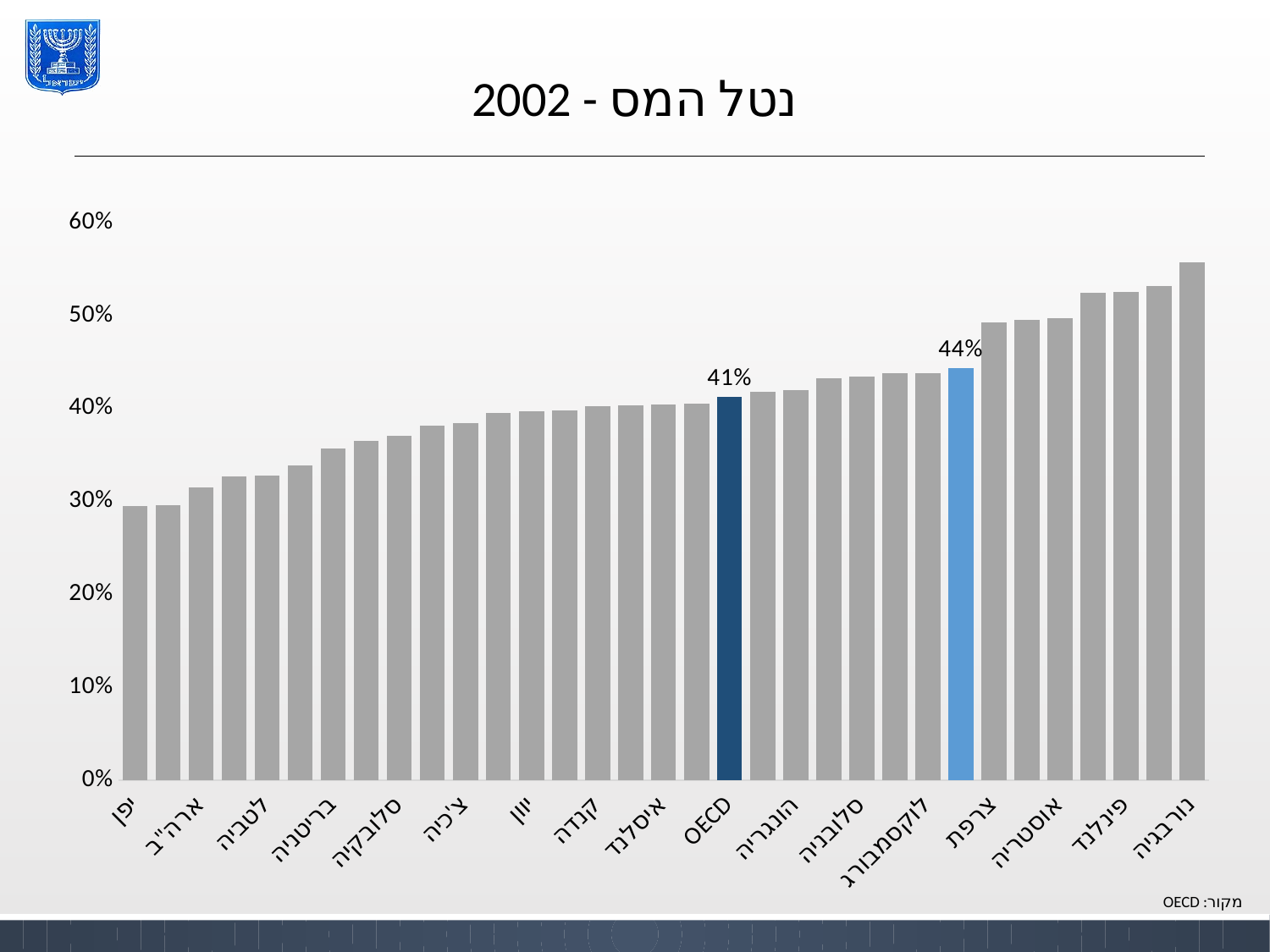
What source is cited for the chart? OECD Which labelled country has the highest value? נורבגיה What is the value shown for OECD? 41% Is the value for בריטניה greater or less than 40%? less What is the title of the chart? נטל המס - 2002 Do the values rise or fall from left to right along the x axis? rise Is the value for נורבגיה greater or less than 50%? greater Is the value for קנדה greater or less than 50%? less What kind of chart is shown on the slide? bar chart Which is larger, the value for צרפת or the value for OECD? צרפת